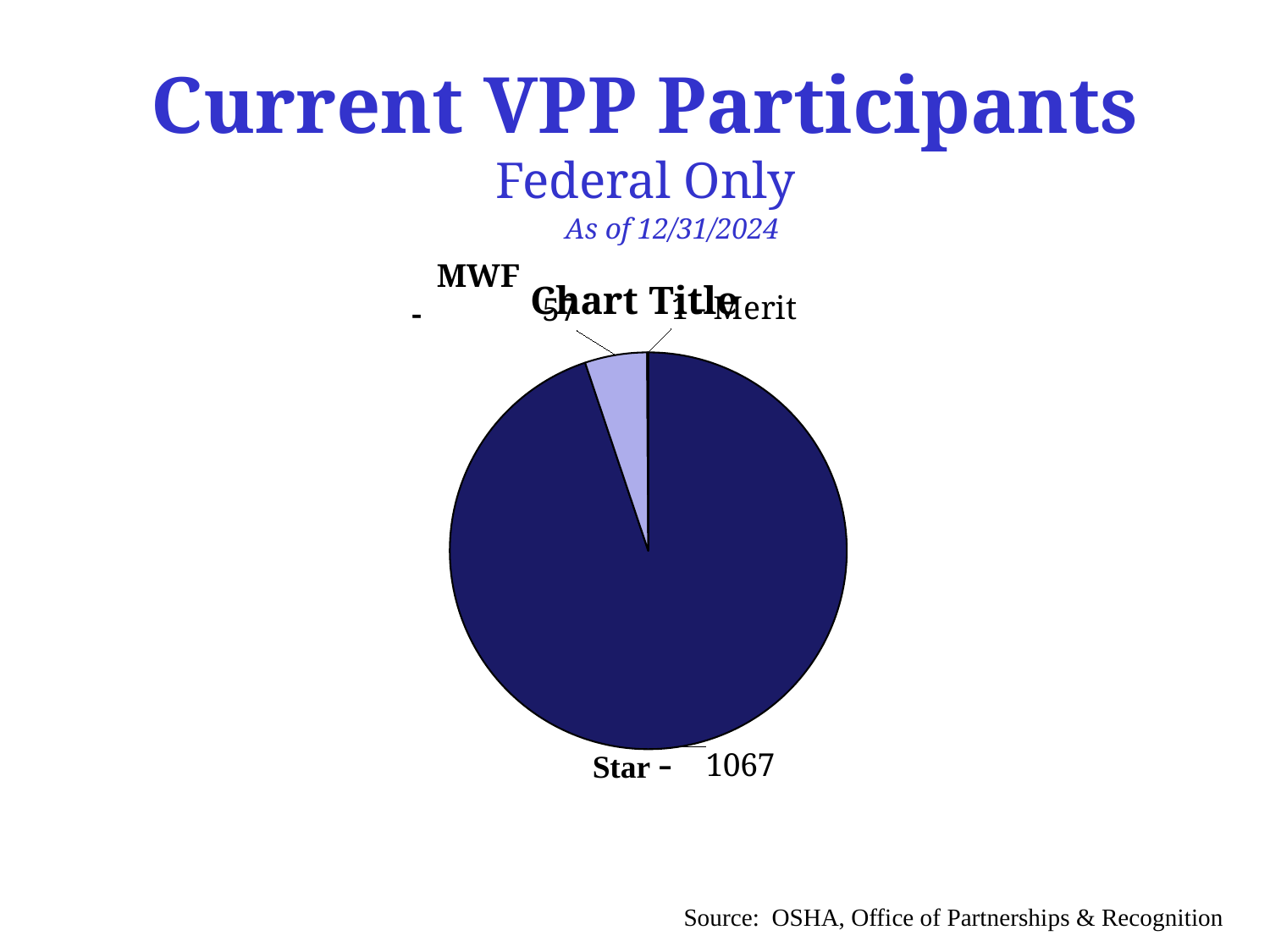
Which is larger, the Star slice or the MWF slice? Star What is the value for the MWF slice? 57 What source is cited at the bottom of the slide? OSHA, Office of Partnerships & Recognition How many slices does the pie chart have? 3 What kind of chart is shown on the slide? pie chart Which category has the largest slice of the pie? Star What is the difference between the Star value and the MWF value? 1010 What title is printed above the pie chart? Chart Title What is the value for the Star slice? 1067 Which category has the smallest slice of the pie? Merit